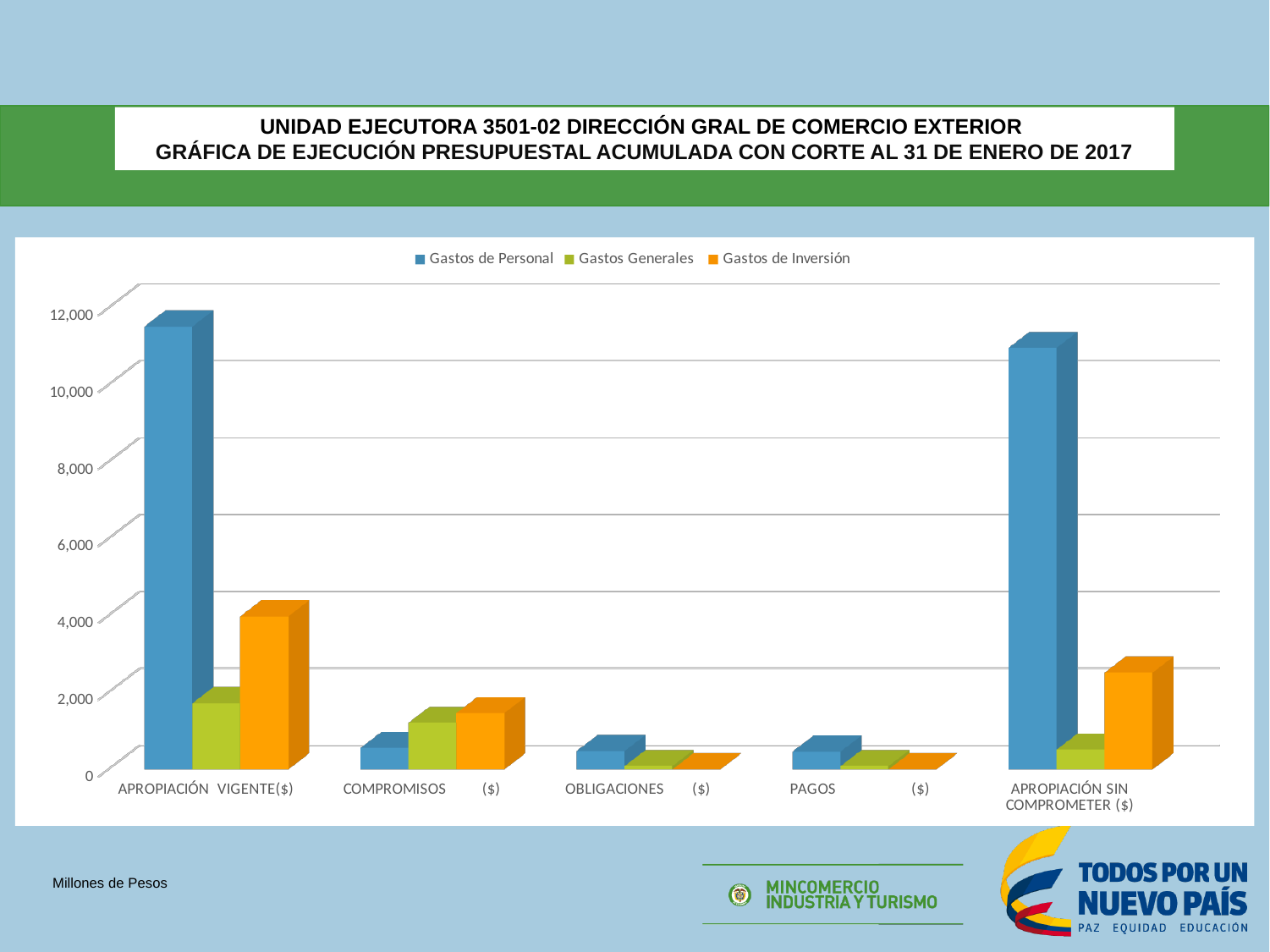
Which series has the highest value for APROPIACIÓN VIGENTE($)? Gastos de Personal Is the value of Gastos de Inversión for APROPIACIÓN VIGENTE($) greater or less than 6,000? less Is the value of Gastos de Personal for APROPIACIÓN SIN COMPROMETER ($) greater or less than 10,000? greater Is the value of Gastos de Inversión for APROPIACIÓN SIN COMPROMETER ($) greater or less than 2,000? greater What kind of chart is shown on the slide? Bar chart For COMPROMISOS ($), which is larger: Gastos de Personal or Gastos de Inversión? Gastos de Inversión How many series does the legend list? 3 What colour represents Gastos de Inversión in the legend? Orange Which series has the lowest value for APROPIACIÓN VIGENTE($)? Gastos Generales How many categories are shown on the x axis? 5